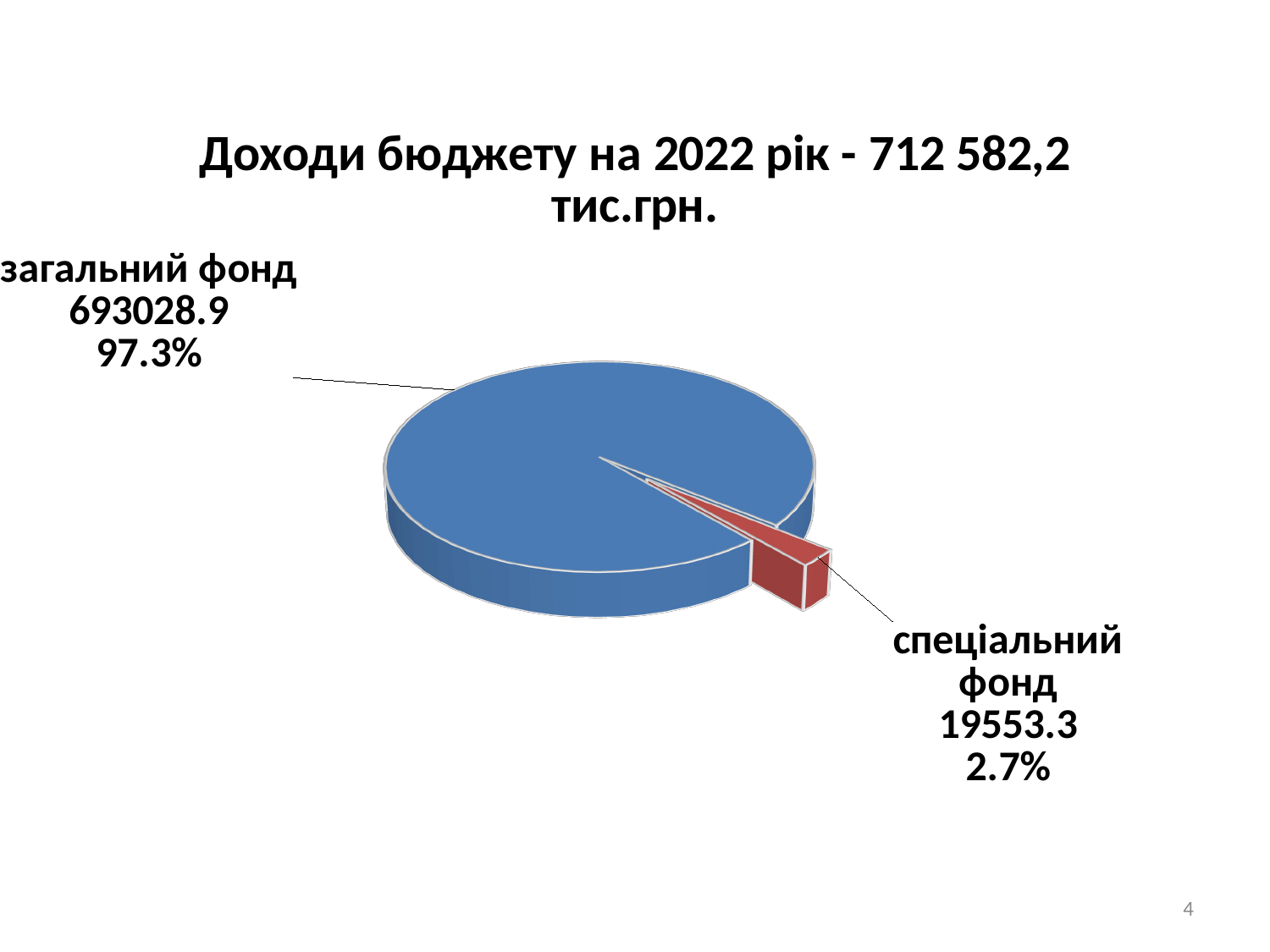
What is the title of the chart? Доходи бюджету на 2022 рік - 712 582,2 тис.грн. What share of the pie does спеціальний фонд represent? 2.7% What is the value for спеціальний фонд? 19553.3 What colour is the slice for спеціальний фонд? red How many slices does the pie chart have? 2 Which category has the smallest slice? спеціальний фонд Which is larger, загальний фонд or спеціальний фонд? загальний фонд What is the value for загальний фонд? 693028.9 What is the difference between the values for загальний фонд and спеціальний фонд? 673475.6 What share of the pie does загальний фонд represent? 97.3% Which category has the largest slice? загальний фонд What kind of chart is shown on the slide? pie chart